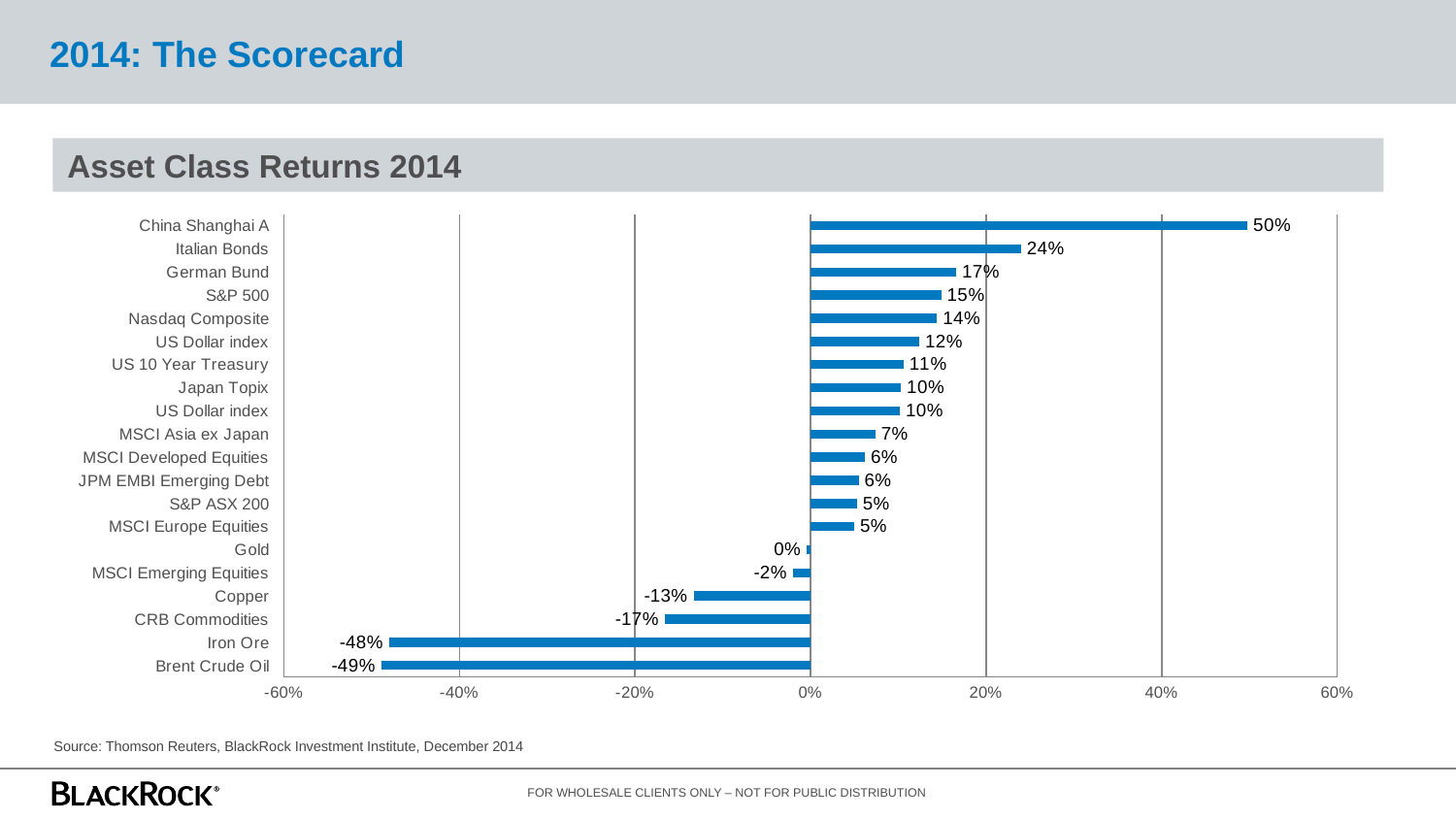
How many asset classes are plotted in the chart? 20 What is the 2014 return shown for Italian Bonds? 24% What is the 2014 return shown for Brent Crude Oil? -49% Which has a higher return, German Bund or Japan Topix? German Bund What is the difference between the returns of the S&P 500 and the Nasdaq Composite? 1% What is the difference between the returns of Copper and CRB Commodities? 4% Which asset class has the highest return in the chart? China Shanghai A What is the title of the chart? Asset Class Returns 2014 What is the 2014 return shown for Gold? 0% What is the 2014 return shown for China Shanghai A? 50% Which asset class has the lowest return in the chart? Brent Crude Oil What kind of chart is shown on the slide? bar chart